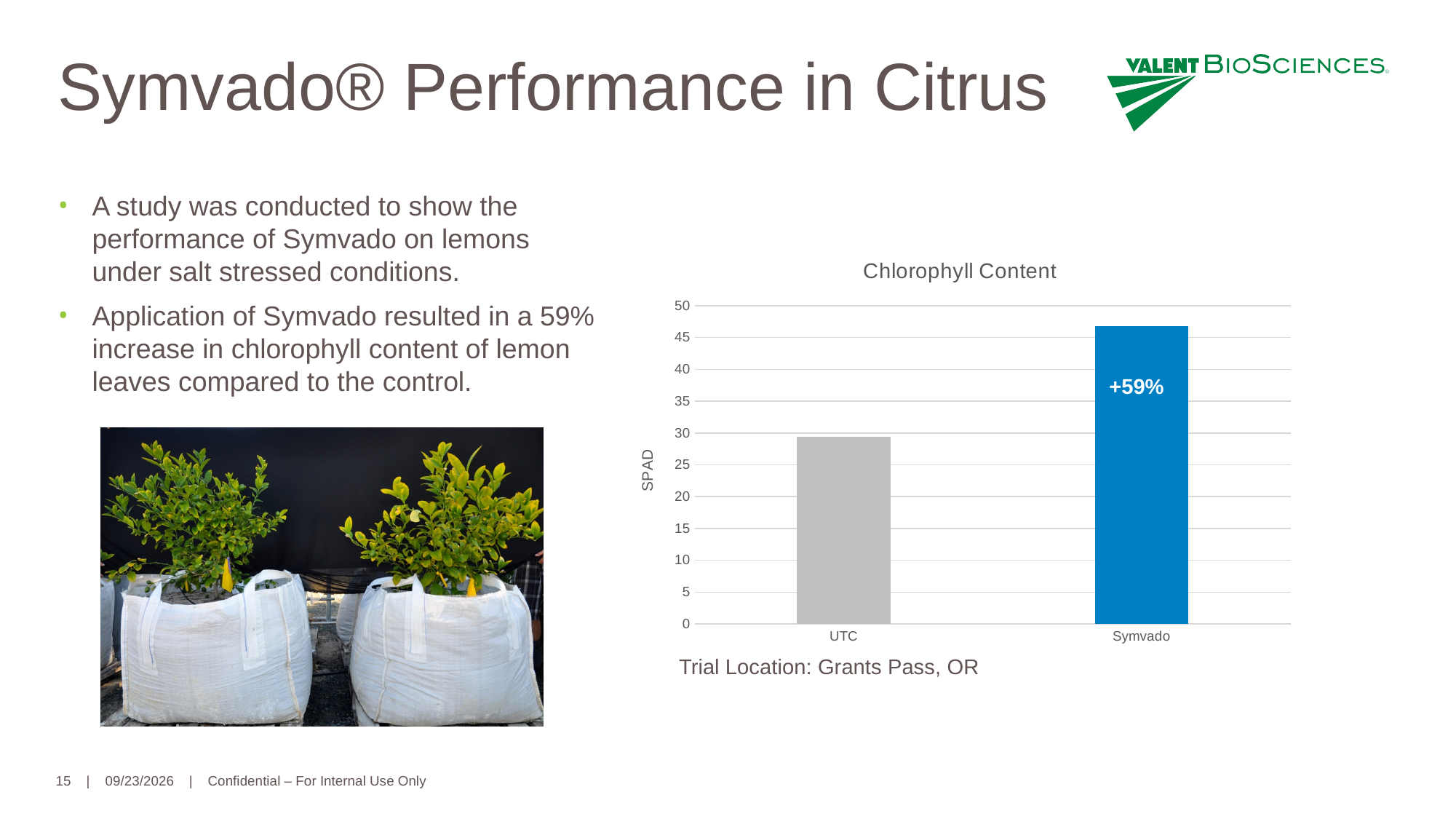
What is the title of the chart? Chlorophyll Content What kind of chart is shown on the slide? bar chart Which category has the lowest chlorophyll content? UTC Which category has the highest chlorophyll content? Symvado Is the value for Symvado greater or less than 50? less What percentage increase is labelled on the Symvado bar? +59% How many categories are plotted in the chart? 2 Which is larger, the value for UTC or the value for Symvado? Symvado Is the value for UTC greater or less than 25? greater What is the label on the vertical axis of the chart? SPAD Is the value for Symvado greater or less than 45? greater